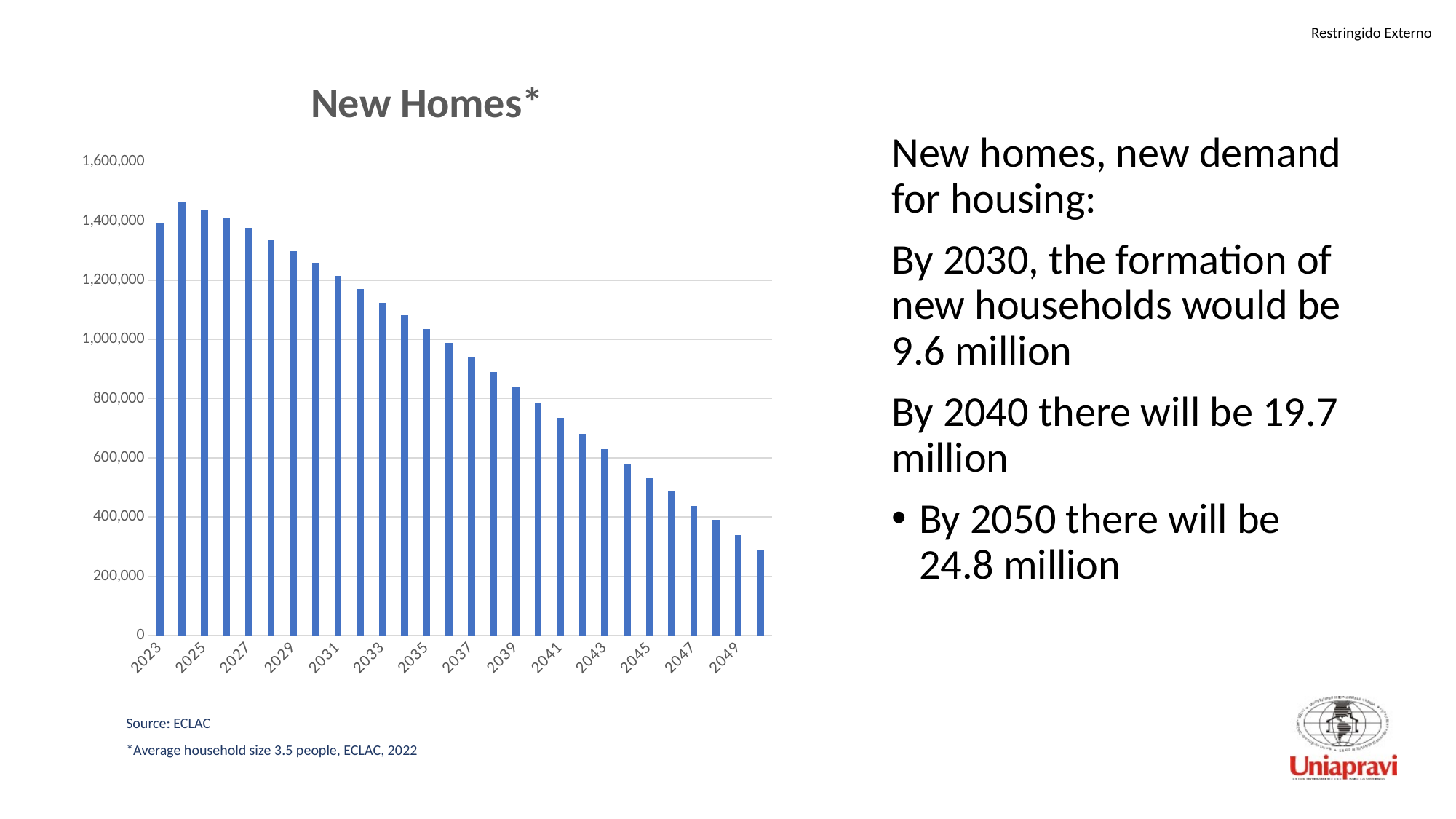
Do the values in the New Homes chart generally rise or fall from 2023 to 2050? fall Which is larger, the value for 2027 or the value for 2037? 2027 Is the value for 2023 greater or less than 1,200,000? greater Which is larger, the value for 2043 or the value for 2033? 2033 Is the value for 2035 greater or less than 1,000,000? greater Which year has the lowest value in the New Homes chart? 2050 What kind of chart is shown on the slide? bar chart Is the value for 2049 greater or less than 400,000? less What is the title of the chart? New Homes* What source is cited below the chart? ECLAC